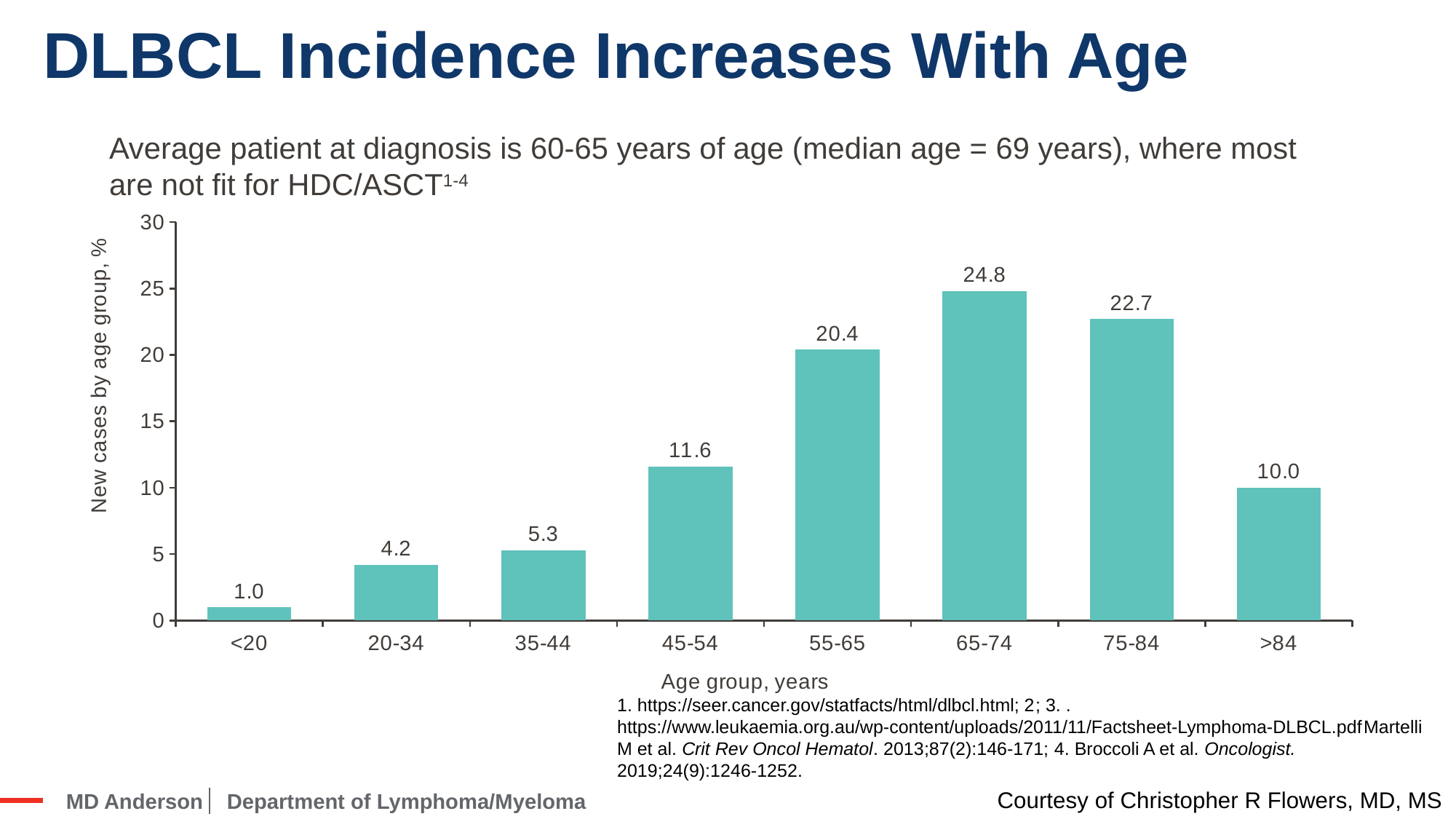
What is the label of the y axis? New cases by age group, % What kind of chart is shown on the slide? bar chart Is the value for >84 greater or less than 15? less Which age group has the highest value? 65-74 Which is larger, the value for 20-34 or the value for 35-44? 35-44 What is the difference between the values for 55-65 and 45-54? 8.8 Which age group has the lowest value? <20 What is the value for the <20 age group? 1.0 How many age groups are shown on the x axis? 8 What is the value for the 45-54 age group? 11.6 What is the difference between the values for 65-74 and 75-84? 2.1 What is the value for the 65-74 age group? 24.8